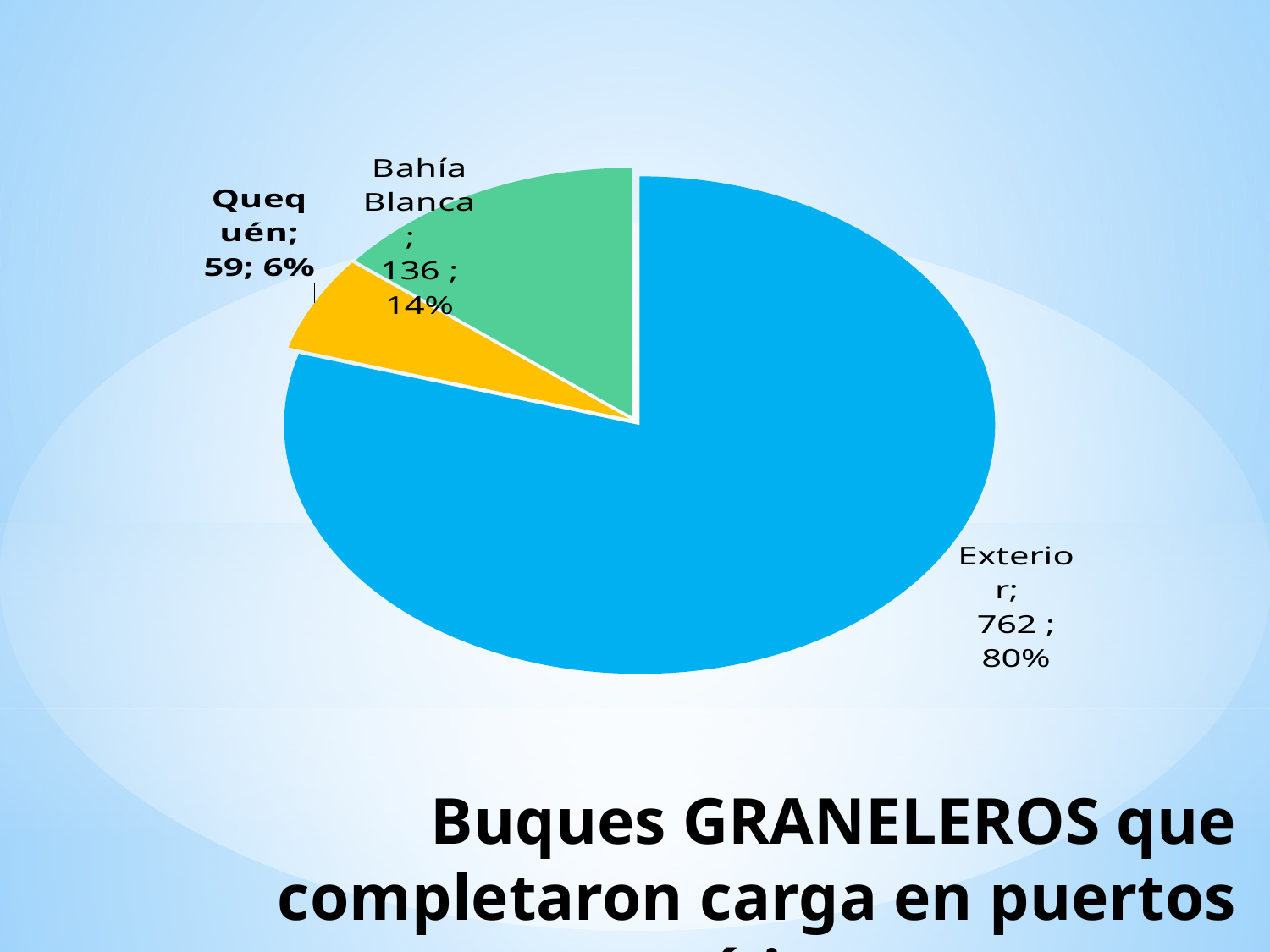
What is the value for Exterior in the pie chart? 762 Which is larger, the value for Bahía Blanca or the value for Quequén? Bahía Blanca What share of the pie does Quequén represent? 6% Which category has the largest slice in the pie chart? Exterior What share of the pie does Exterior represent? 80% What share of the pie does Bahía Blanca represent? 14% How many slices does the pie chart have? 3 What is the value for Quequén in the pie chart? 59 What is the value for Bahía Blanca in the pie chart? 136 What is the difference between the values for Bahía Blanca and Quequén? 77 What kind of chart is shown on the slide? pie chart Which category has the smallest slice in the pie chart? Quequén